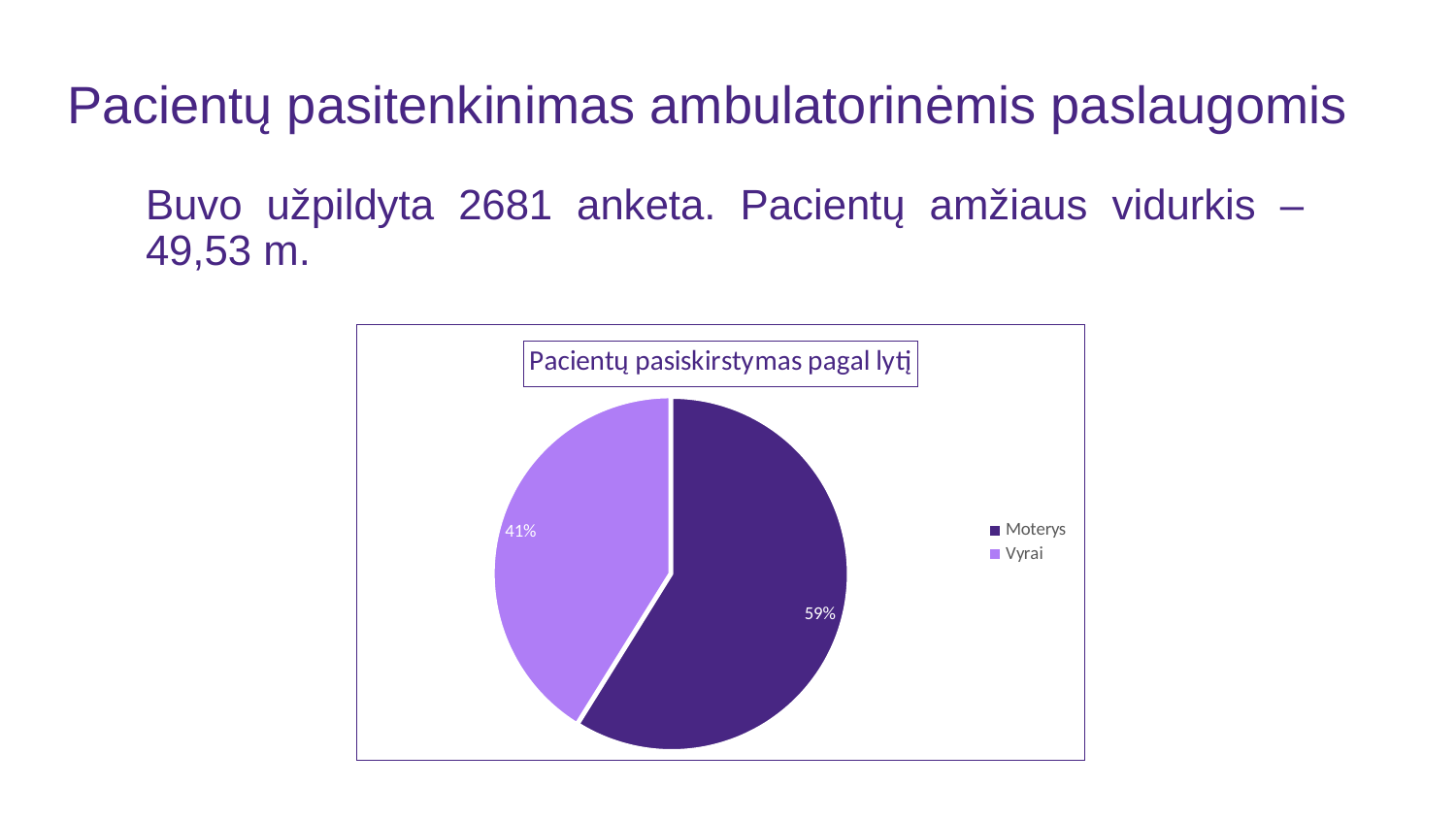
What share of the pie does Moterys represent? 59% Which slice is larger, Moterys or Vyrai? Moterys Which category has the smallest slice of the pie? Vyrai What is the difference in percentage points between the Moterys and Vyrai slices? 18% Which category has the largest slice of the pie? Moterys How many entries does the legend list? 2 What kind of chart is shown on the slide? pie chart Which category is shown in the lighter purple colour? Vyrai What share of the pie does Vyrai represent? 41% What is the title of the chart? Pacientų pasiskirstymas pagal lytį How many categories does the pie chart show? 2